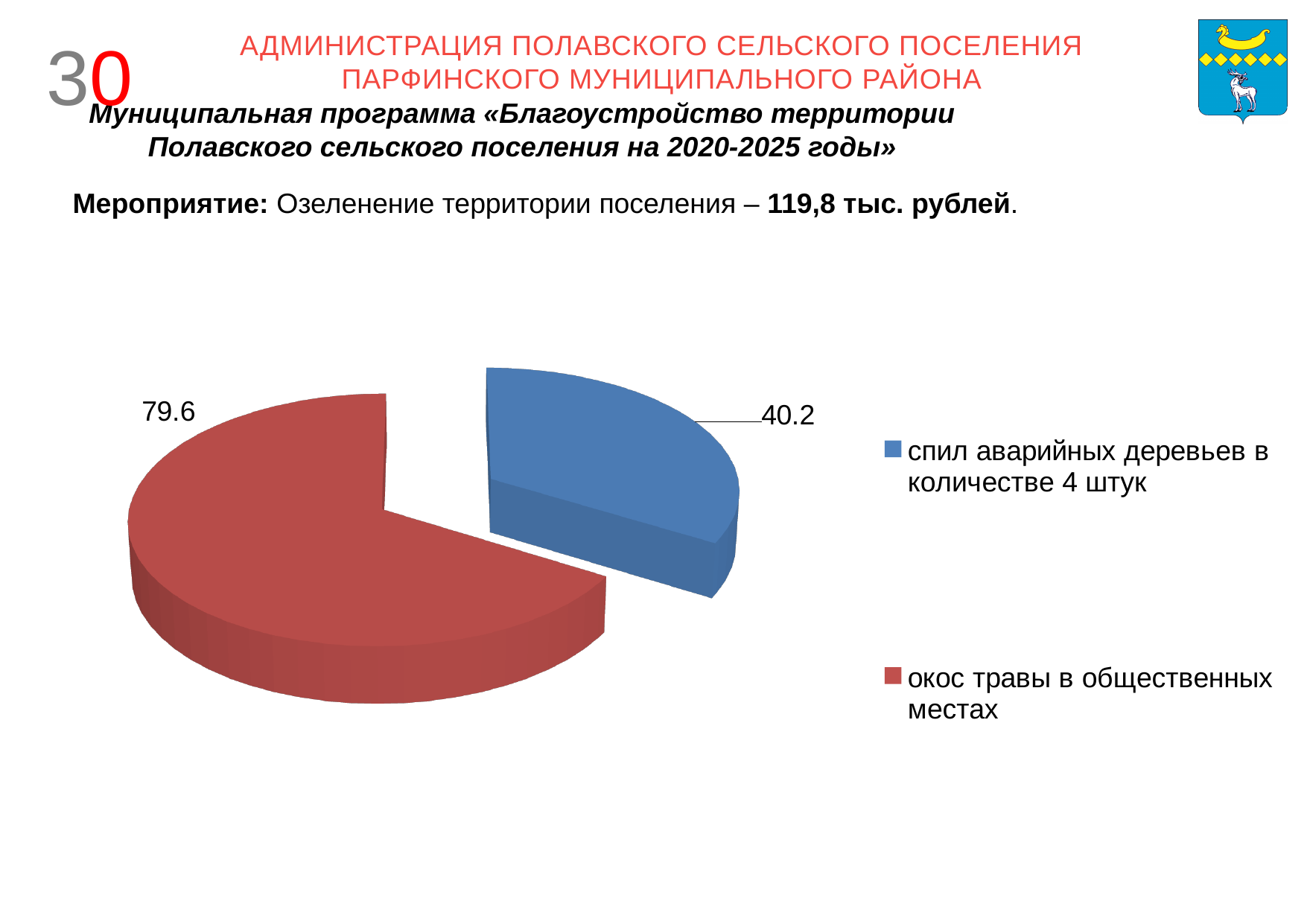
Which is larger: the value for 'спил аварийных деревьев в количестве 4 штук' or for 'окос травы в общественных местах'? окос травы в общественных местах What colour is the slice for 'спил аварийных деревьев в количестве 4 штук'? blue What is the total of the two slice values in the pie chart? 119.8 How many entries does the legend list? 2 What value is shown for the slice 'окос травы в общественных местах'? 79.6 How many slices does the pie chart have? 2 What value is shown for the slice 'спил аварийных деревьев в количестве 4 штук'? 40.2 What is the difference between the values for 'окос травы в общественных местах' and 'спил аварийных деревьев в количестве 4 штук'? 39.4 What kind of chart is shown on the slide? pie chart Which category has the smallest slice of the pie? спил аварийных деревьев в количестве 4 штук Which category has the largest slice of the pie? окос травы в общественных местах What colour is the slice for 'окос травы в общественных местах'? red